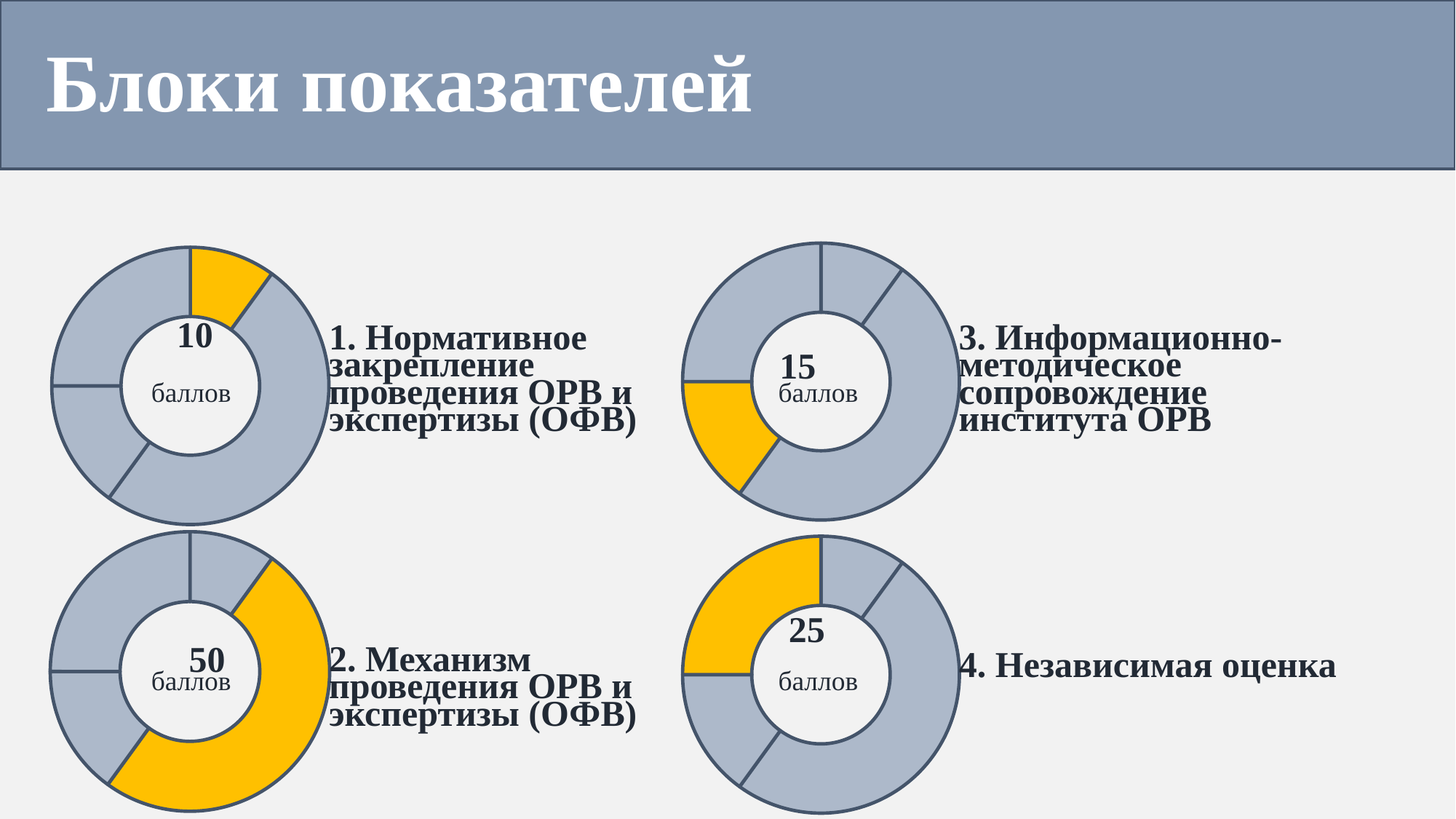
What type of chart is used for each block on the slide? Donut (pie) chart What is the difference in points between block 2 (Механизм проведения ОРВ) and block 4 (Независимая оценка)? 25 What is the total number of points across all four blocks shown on the slide? 100 Which has more points: block 3 (Информационно-методическое сопровождение) or block 4 (Независимая оценка)? 4. Независимая оценка Which block has the highest number of points across the four donut charts? 2. Механизм проведения ОРВ и экспертизы (ОФВ) What value is shown in the centre of the donut chart for block 2 (Механизм проведения ОРВ и экспертизы (ОФВ))? 50 баллов What value is shown in the centre of the donut chart for block 4 (Независимая оценка)? 25 баллов What colour is used to highlight the slice corresponding to each block in the donut charts? Yellow How many slices does each donut chart on the slide have? 4 What value is shown in the centre of the donut chart for block 3 (Информационно-методическое сопровождение института ОРВ)? 15 баллов What value is shown in the centre of the donut chart for block 1 (Нормативное закрепление проведения ОРВ и экспертизы (ОФВ))? 10 баллов Which block has the lowest number of points across the four donut charts? 1. Нормативное закрепление проведения ОРВ и экспертизы (ОФВ)